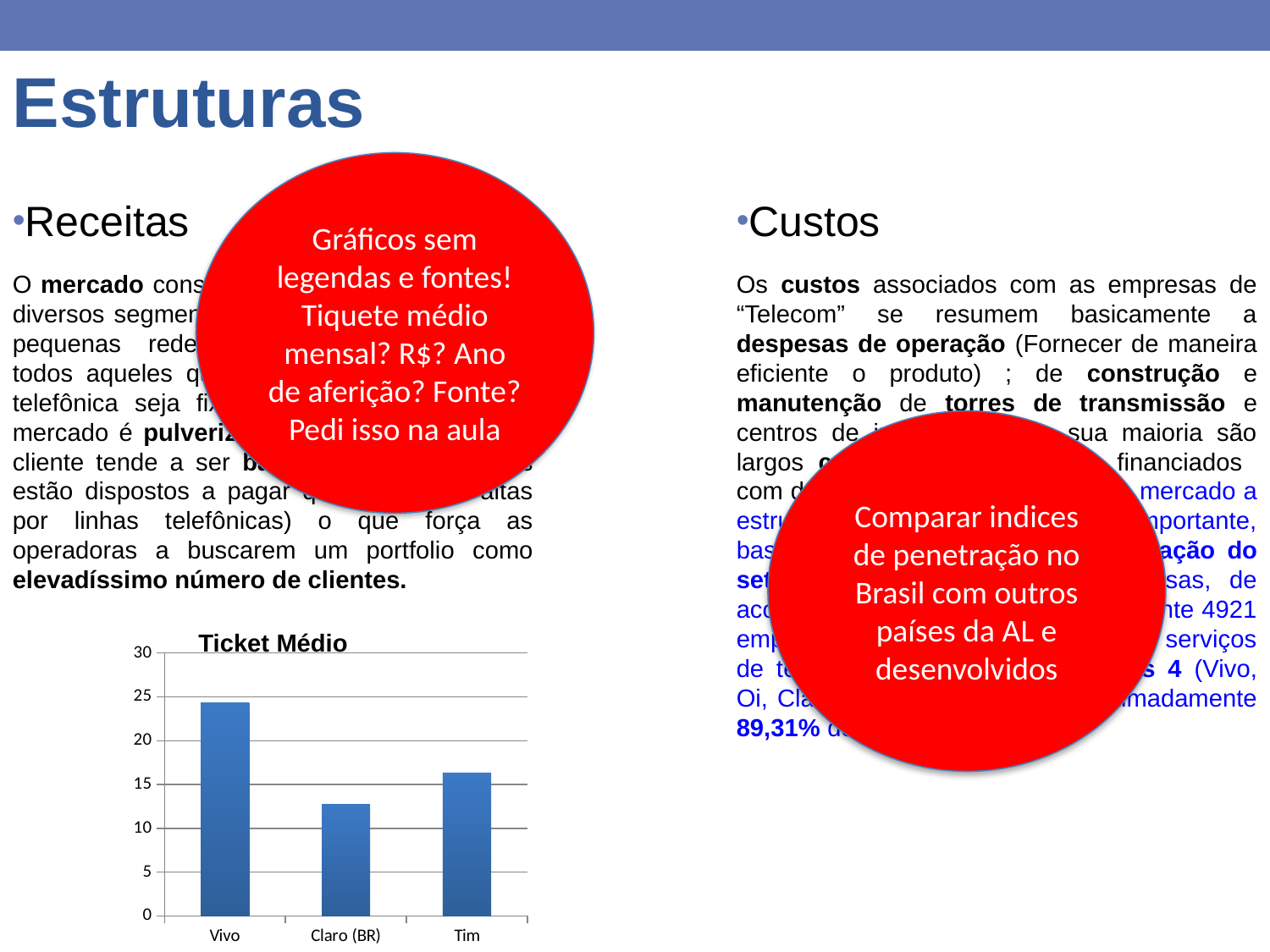
Which category has the lowest value in the Ticket Médio chart? Claro (BR) Is the value for Claro (BR) in the Ticket Médio chart greater or less than 15? less What is the maximum value shown on the vertical axis of the Ticket Médio chart? 30 How many categories are plotted in the Ticket Médio chart? 3 Which category has the highest value in the Ticket Médio chart? Vivo Is the value for Vivo in the Ticket Médio chart greater or less than 20? greater In the Ticket Médio chart, which is larger, the value for Tim or the value for Claro (BR)? Tim What is the title of the chart on the slide? Ticket Médio In the Ticket Médio chart, which is larger, the value for Vivo or the value for Tim? Vivo What kind of chart is shown on the slide? bar chart Is the value for Tim in the Ticket Médio chart greater or less than 15? greater